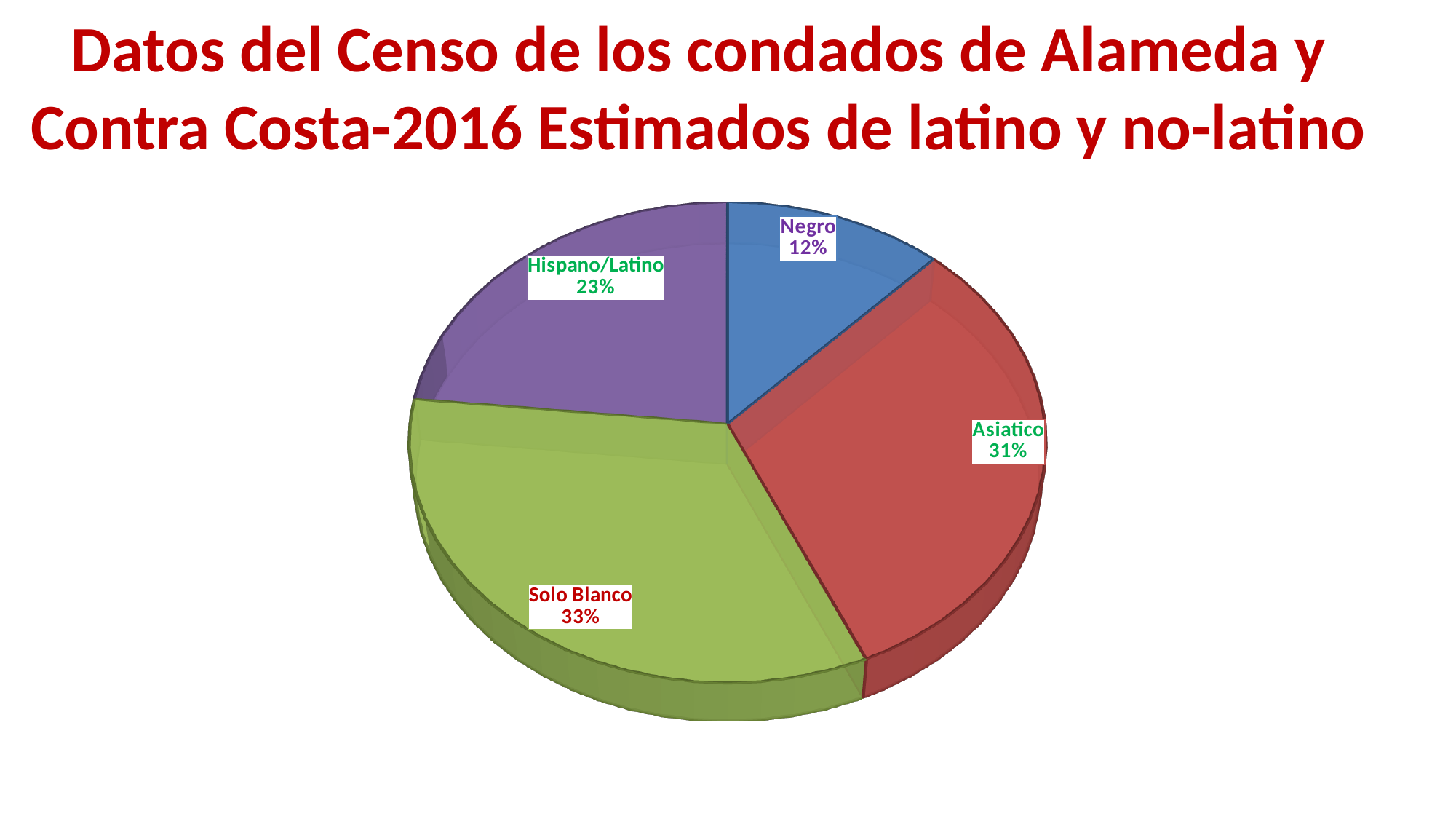
Which slice is larger, Hispano/Latino or Asiatico? Asiatico What colour is the Solo Blanco slice? Green How many slices does the pie chart have? 4 What percentage of the pie does the Negro slice represent? 12% What percentage is shown for the Solo Blanco slice? 33% Which category has the smallest share of the pie? Negro Which category has the largest share of the pie? Solo Blanco What percentage is shown for the Asiatico slice? 31% What kind of chart is shown on the slide? Pie chart What percentage is shown for the Hispano/Latino slice? 23% What is the difference in percentage points between the Asiatico and Hispano/Latino slices? 8 What is the difference in percentage points between the Solo Blanco and Negro slices? 21